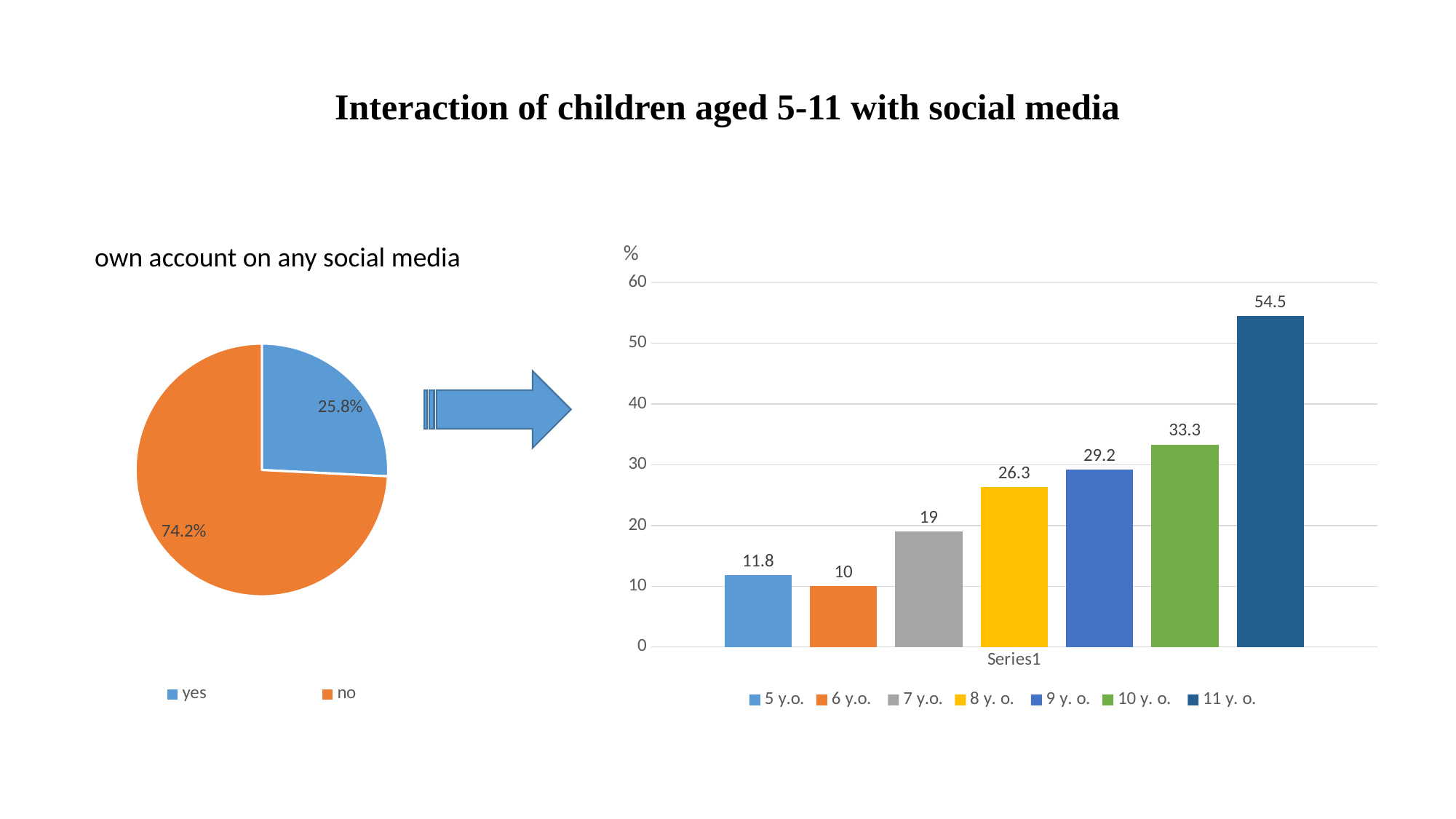
In the pie chart titled 'own account on any social media', what share is labelled 'yes'? 25.8% In the bar chart on the right, what is the value for 11 y. o.? 54.5 In the bar chart on the right, what is the difference between the values for 11 y. o. and 10 y. o.? 21.2 In the bar chart on the right, what is the value for 7 y.o.? 19 How many series does the legend of the bar chart on the right list? 7 In the bar chart on the right, is the value for 9 y. o. greater or less than 30? less What kind of chart is the chart on the right of the slide? bar chart What kind of chart is the chart on the left of the slide? pie chart In the pie chart on the left, which slice is larger, 'yes' or 'no'? no In the pie chart titled 'own account on any social media', what share is labelled 'no'? 74.2% In the bar chart on the right, which age group has the lowest value? 6 y.o. In the bar chart on the right, which age group has the highest value? 11 y. o.